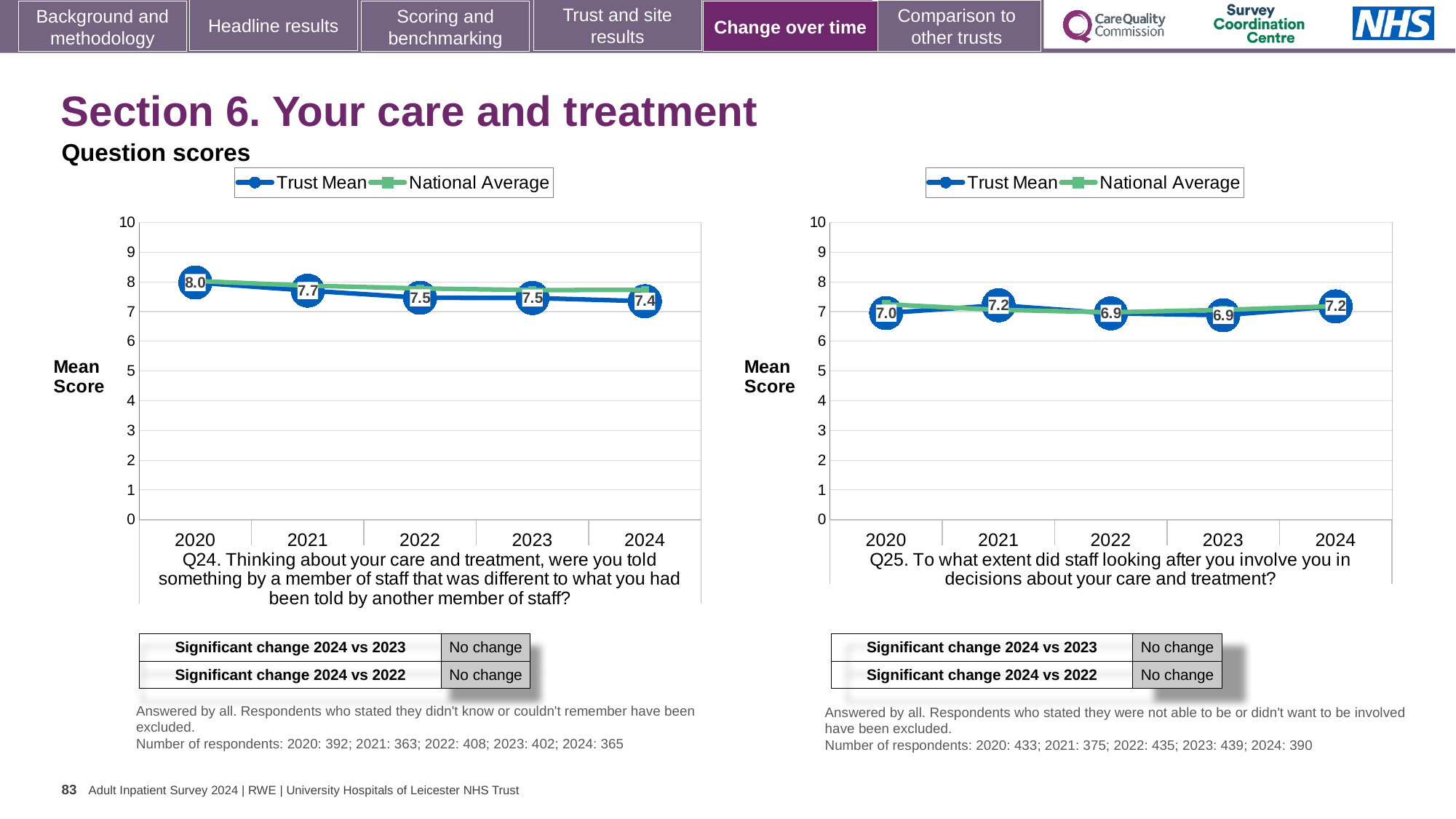
On the Q25 chart (right), is the Trust Mean score for 2022 greater or less than 8? less On the Q25 chart (right), what is the Trust Mean score for 2021? 7.2 On the Q24 chart (left), what is the Trust Mean score for 2020? 8.0 On the Q24 chart (left), does the Trust Mean generally rise or fall from 2020 to 2024? fall How many years are plotted on the x axis of the Q25 chart (right)? 5 What type of chart is the Q24 chart (left)? line chart On the Q25 chart (right), what is the Trust Mean score for 2023? 6.9 On the Q24 chart (left), which year has the highest Trust Mean score? 2020 On the Q24 chart (left), what is the Trust Mean score for 2024? 7.4 On the Q24 chart (left), what is the difference between the Trust Mean scores for 2020 and 2024? 0.6 How many series does the legend of the Q24 chart (left) list? 2 On the Q25 chart (right), which year has the lowest Trust Mean score, 2020 or 2022? 2022